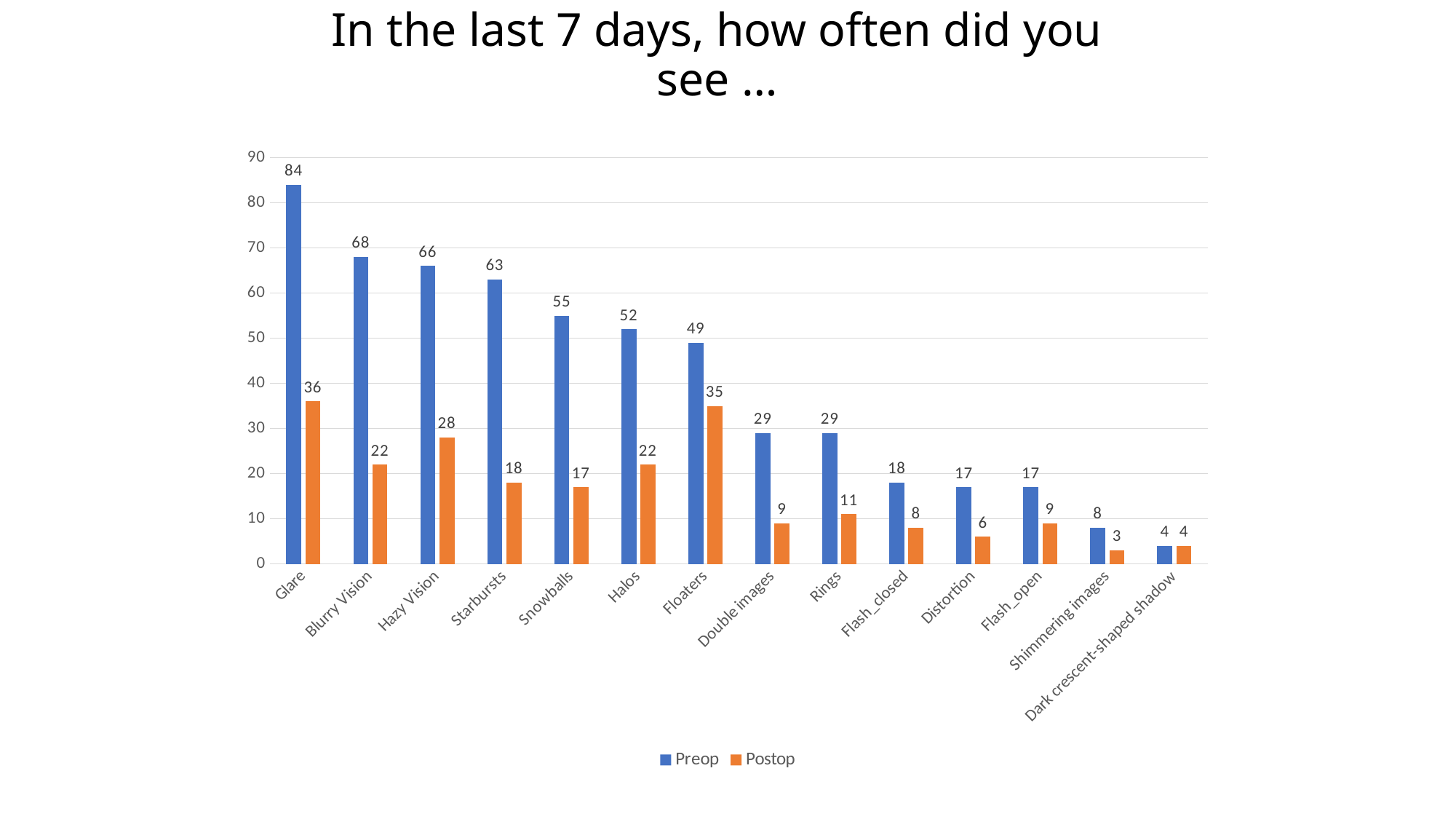
Which is larger, the Postop value for Halos or the Postop value for Starbursts? Halos Do the Preop values rise or fall from left to right along the x axis? Fall What is the Postop value for Hazy Vision? 28 What is the difference between the Preop and Postop values for Blurry Vision? 46 Which category has the highest Preop value? Glare Which category has the lowest Postop value? Shimmering images What is the Postop value for Floaters? 35 What kind of chart is shown on the slide? Bar chart What is the Preop value for Glare? 84 How many series does the legend list? 2 How many categories are shown on the x axis? 14 What colour are the Postop bars? Orange